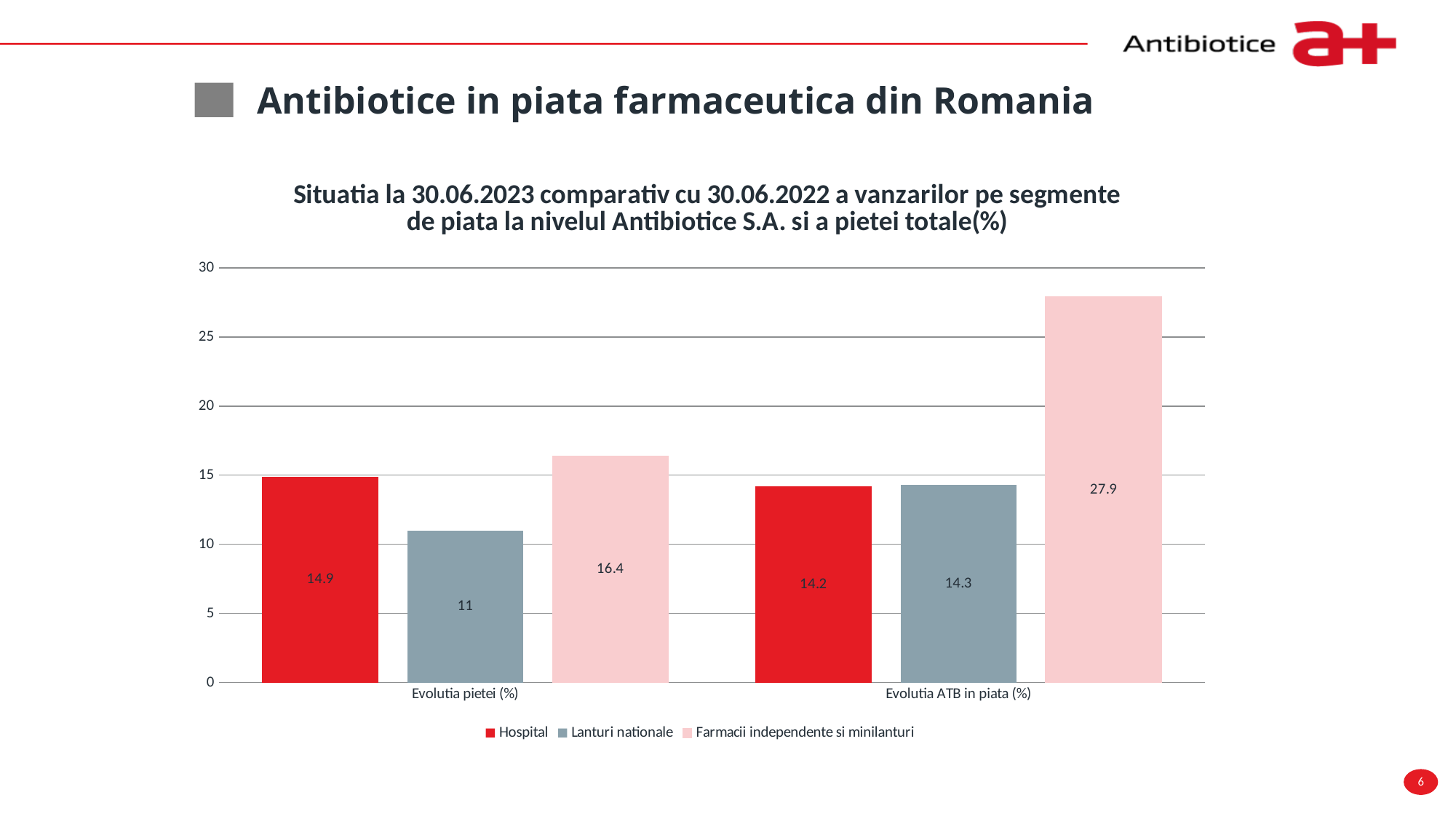
Which is larger: the Hospital value for Evolutia pietei (%) or the Hospital value for Evolutia ATB in piata (%)? Evolutia pietei (%) What is the value for Hospital in the Evolutia ATB in piata (%) group? 14.2 How many category groups are shown on the x axis? 2 What is the difference between the Farmacii independente si minilanturi values for Evolutia ATB in piata (%) and Evolutia pietei (%)? 11.5 What kind of chart is shown on the slide? Bar chart What is the value for Lanturi nationale in the Evolutia pietei (%) group? 11 Which series has the highest value in the Evolutia ATB in piata (%) group? Farmacii independente si minilanturi Which series has the lowest value in the Evolutia pietei (%) group? Lanturi nationale How many series does the legend list? 3 What is the value for Farmacii independente si minilanturi in the Evolutia ATB in piata (%) group? 27.9 What is the value for Hospital in the Evolutia pietei (%) group? 14.9 Is the value for Farmacii independente si minilanturi in the Evolutia ATB in piata (%) group greater or less than 25? greater